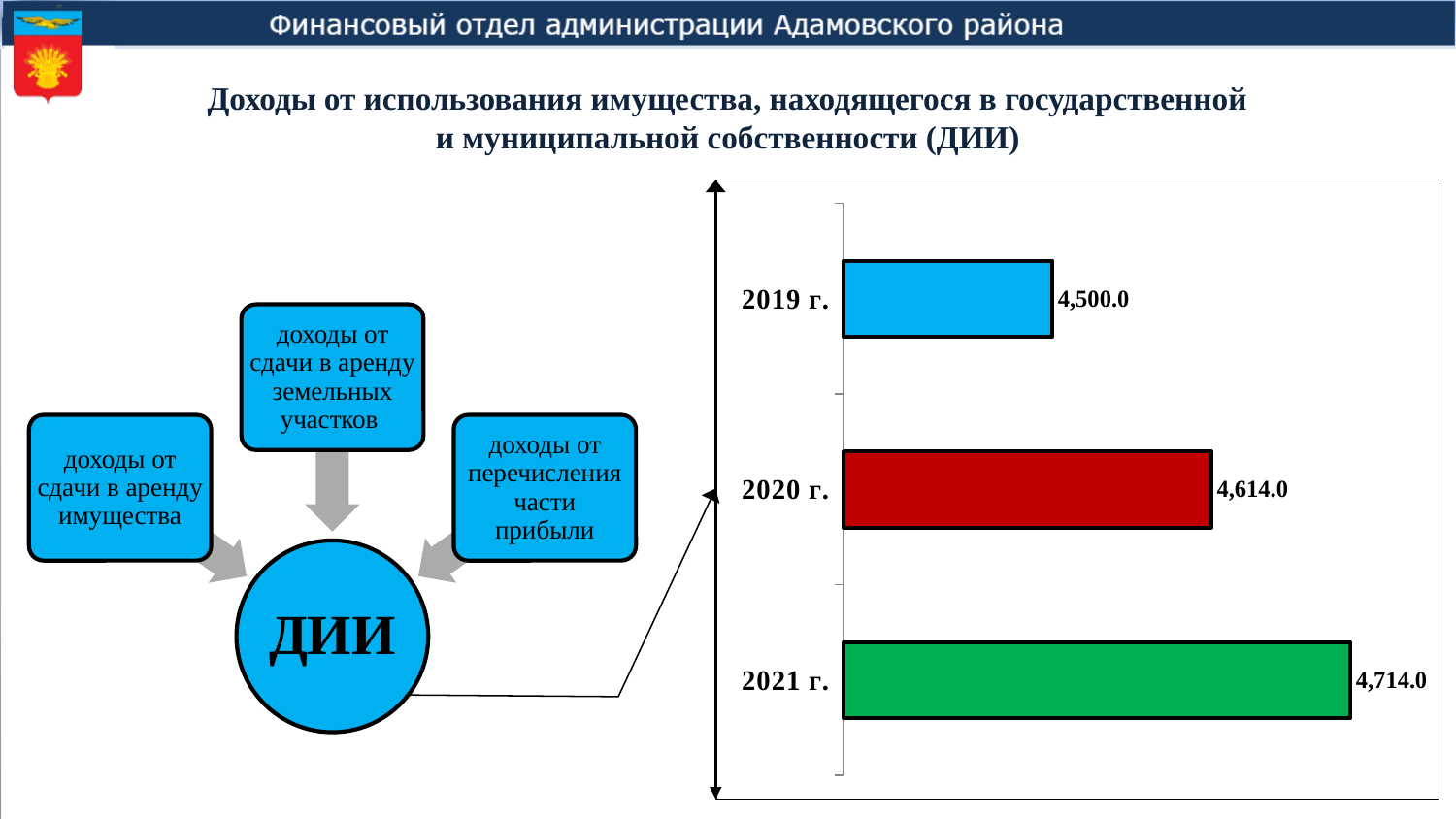
Which is larger, the value for 2020 г. or the value for 2019 г.? 2020 г. Which year has the lowest value? 2019 г. Do the values rise or fall from 2019 г. to 2021 г.? rise What kind of chart is shown on the slide? bar chart Which year has the highest value? 2021 г. What is the difference between the values for 2021 г. and 2020 г.? 100.0 What is the value for 2020 г.? 4,614.0 How many years are shown in the chart? 3 What is the difference between the values for 2020 г. and 2019 г.? 114.0 What is the value for 2021 г.? 4,714.0 What is the difference between the values for 2021 г. and 2019 г.? 214.0 What is the value for 2019 г.? 4,500.0